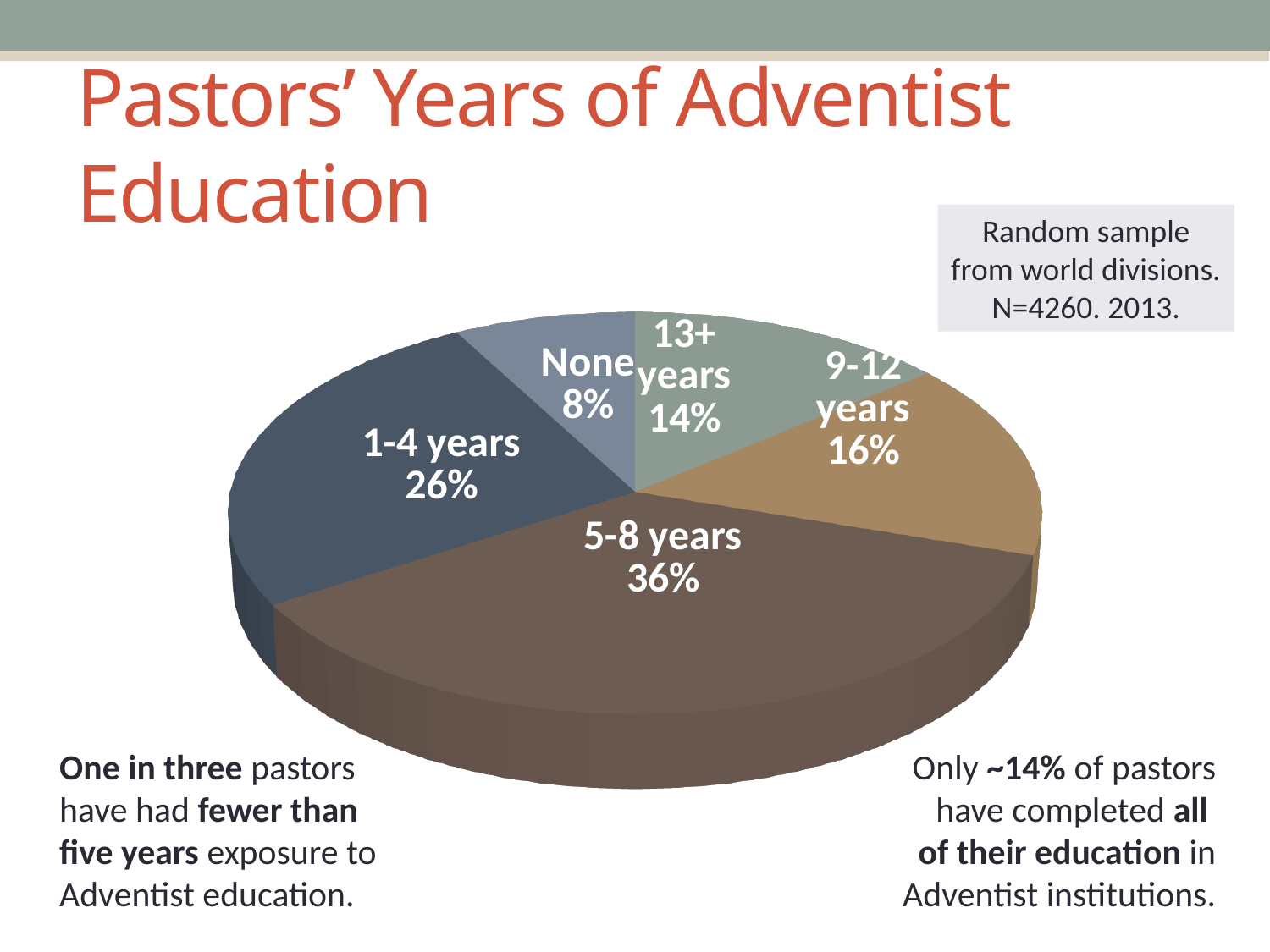
What kind of chart is shown on the slide? Pie chart What share of pastors have 9-12 years of Adventist education? 16% What is the difference in percentage points between the 5-8 years slice and the 1-4 years slice? 10 What share of pastors have 5-8 years of Adventist education? 36% What share of pastors have no Adventist education (None)? 8% What is the title of the slide containing the chart? Pastors' Years of Adventist Education What share of pastors have 13+ years of Adventist education? 14% How many categories (slices) does the pie chart have? 5 Which category has the largest share of the pie? 5-8 years What is the combined share of the None and 1-4 years slices? 34% Which is larger, the share for 9-12 years or the share for 13+ years? 9-12 years Which category has the smallest share of the pie? None